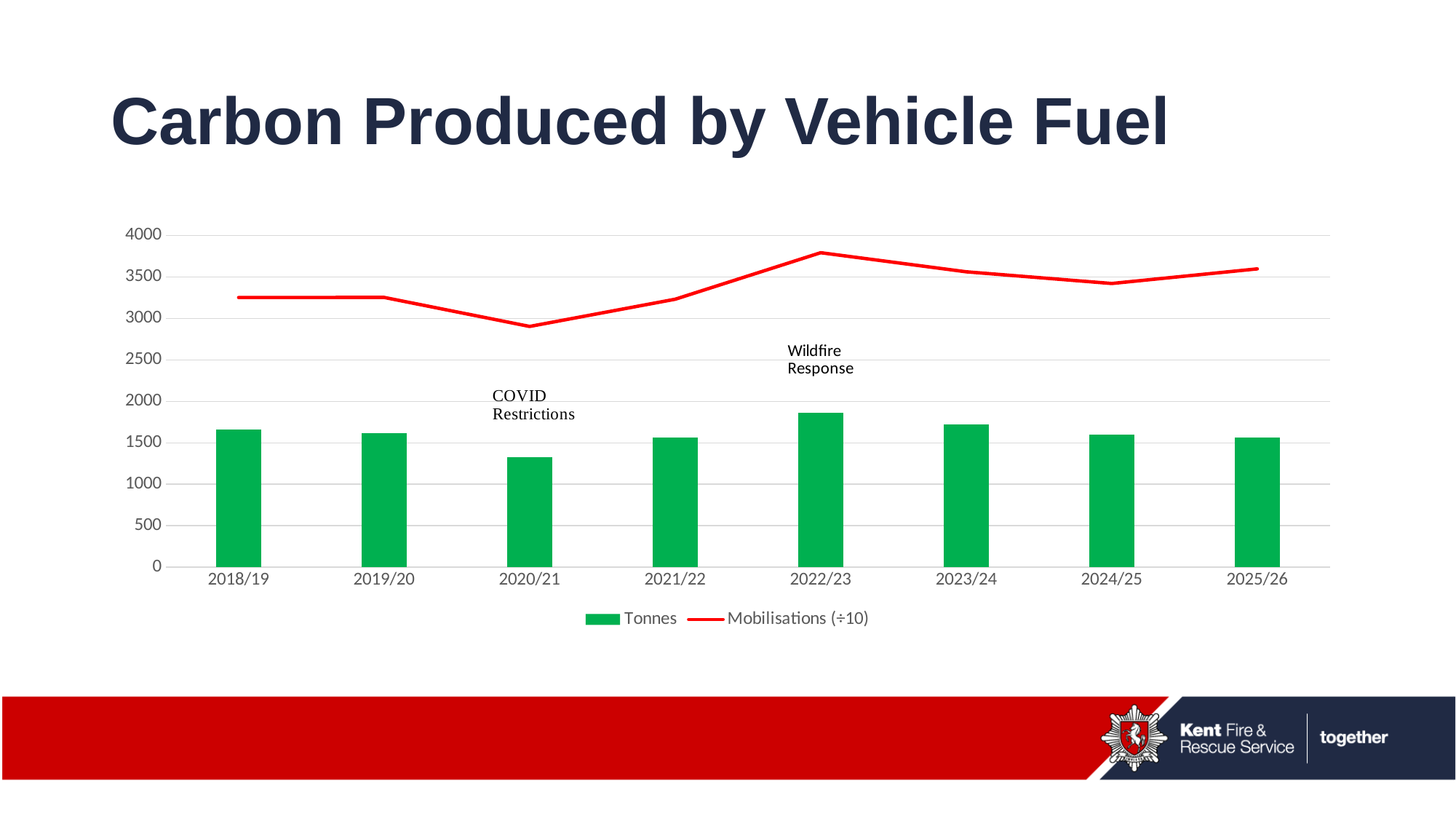
Which year has the larger Tonnes value, 2018/19 or 2020/21? 2018/19 Is the Tonnes value for 2020/21 greater or less than 1500? less What kind of chart is shown on the slide? A combined bar and line chart Which year has the highest Tonnes bar? 2022/23 Which year has the lowest Tonnes bar? 2020/21 In which year does the Mobilisations (÷10) line reach its lowest point? 2020/21 Do the Tonnes values rise or fall from 2022/23 to 2025/26? fall How many financial years are shown on the x axis? 8 How many series does the legend list? 2 In which year does the Mobilisations (÷10) line reach its highest point? 2022/23 Is the Mobilisations (÷10) value for 2022/23 greater or less than 3500? greater Is the Mobilisations (÷10) value for 2020/21 greater or less than 3000? less